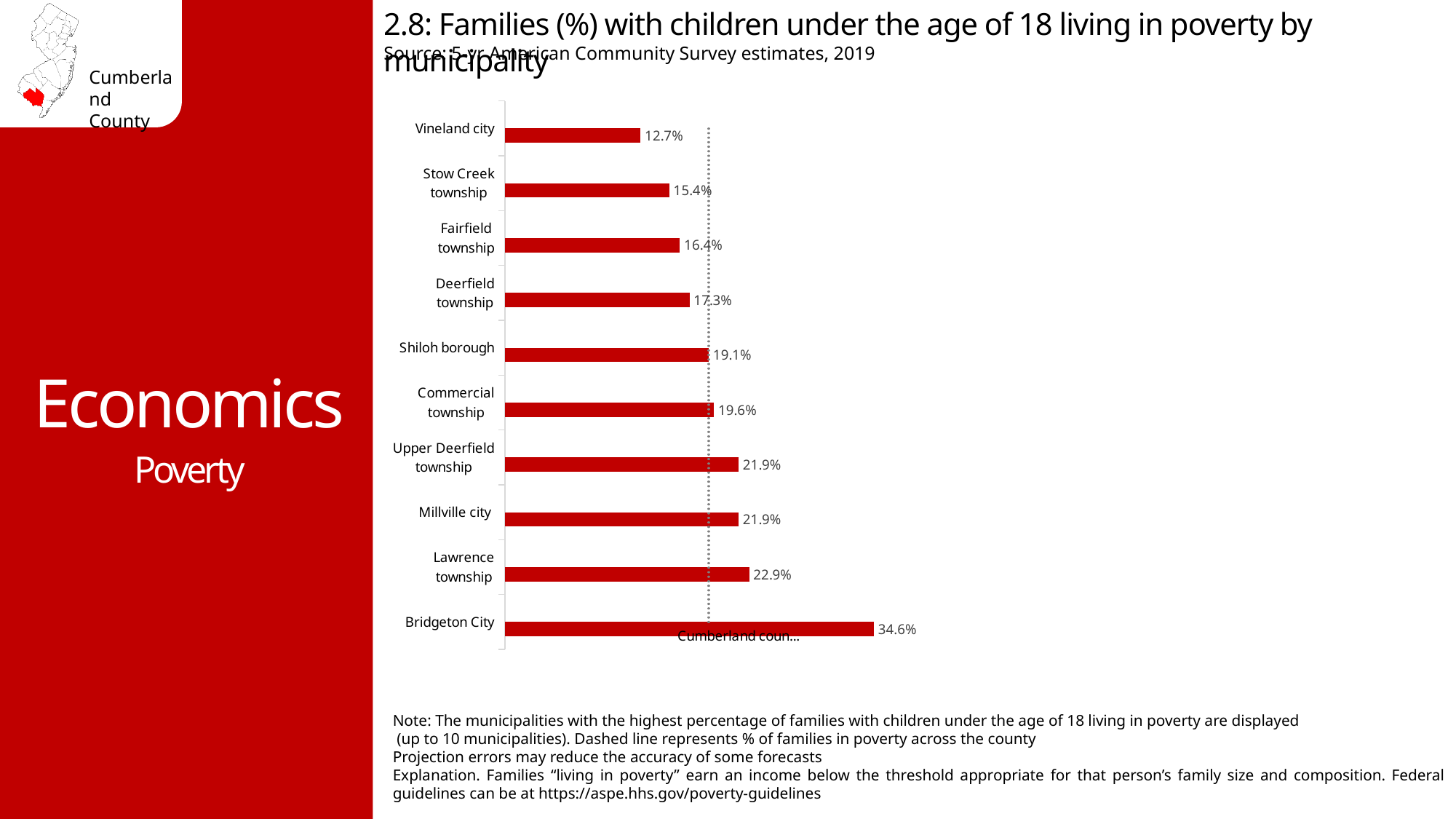
Which municipality has the highest percentage of families with children under 18 living in poverty? Bridgeton City What is the difference between the values for Bridgeton City and Lawrence township? 11.7% What is the value for Shiloh borough? 19.1% What is the value for Bridgeton City? 34.6% What kind of chart is shown on the slide? Bar chart Which is larger, the value for Commercial township or the value for Deerfield township? Commercial township Which municipality has the lowest percentage of families with children under 18 living in poverty? Vineland city What does the dashed vertical line in the chart represent? % of families in poverty across the county What is the value for Lawrence township? 22.9% What is the difference between the values for Fairfield township and Vineland city? 3.7% What is the value for Vineland city? 12.7% How many municipalities are shown in the chart? 10